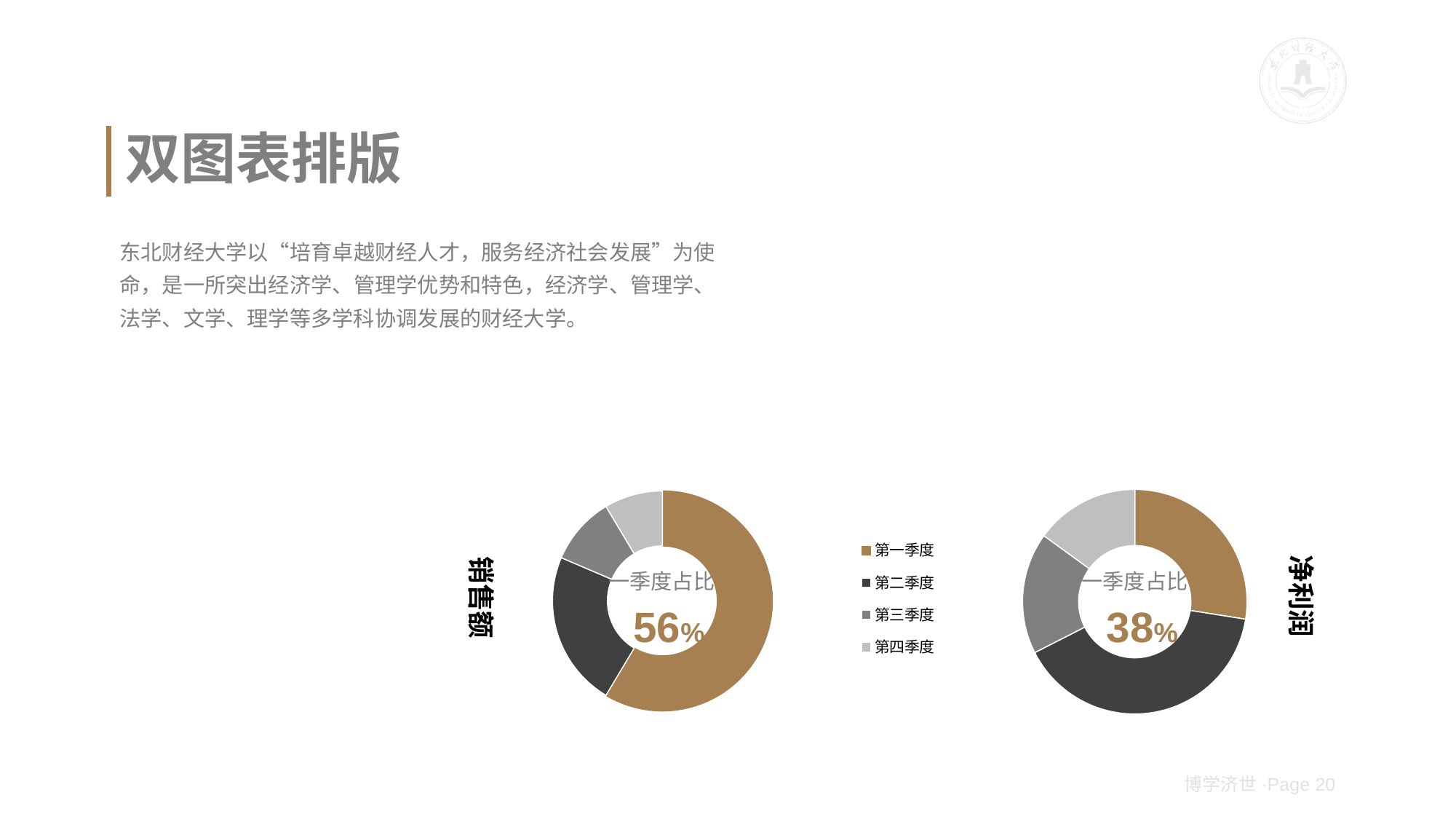
What kind of chart is the 净利润 chart on the right? doughnut (pie) chart In the 净利润 chart on the right, what share does 第一季度 (一季度占比) have? 38% How many slices does the 销售额 chart on the left have? 4 In the 销售额 chart on the left, which slice is larger, 第一季度 or 第二季度? 第一季度 Which legend entry is shown in the gold/brown colour? 第一季度 In the 销售额 chart on the left, what share does 第一季度 (一季度占比) have? 56% Which chart has the larger 第一季度 share, 销售额 or 净利润? 销售额 In the 净利润 chart on the right, which slice is larger, 第三季度 or 第四季度? 第三季度 In the 销售额 chart on the left, which quarter has the largest slice? 第一季度 What is the difference between the 第一季度 share in the 销售额 chart and the 第一季度 share in the 净利润 chart? 18% How many series does the legend list? 4 What kind of chart is the 销售额 chart on the left? doughnut (pie) chart